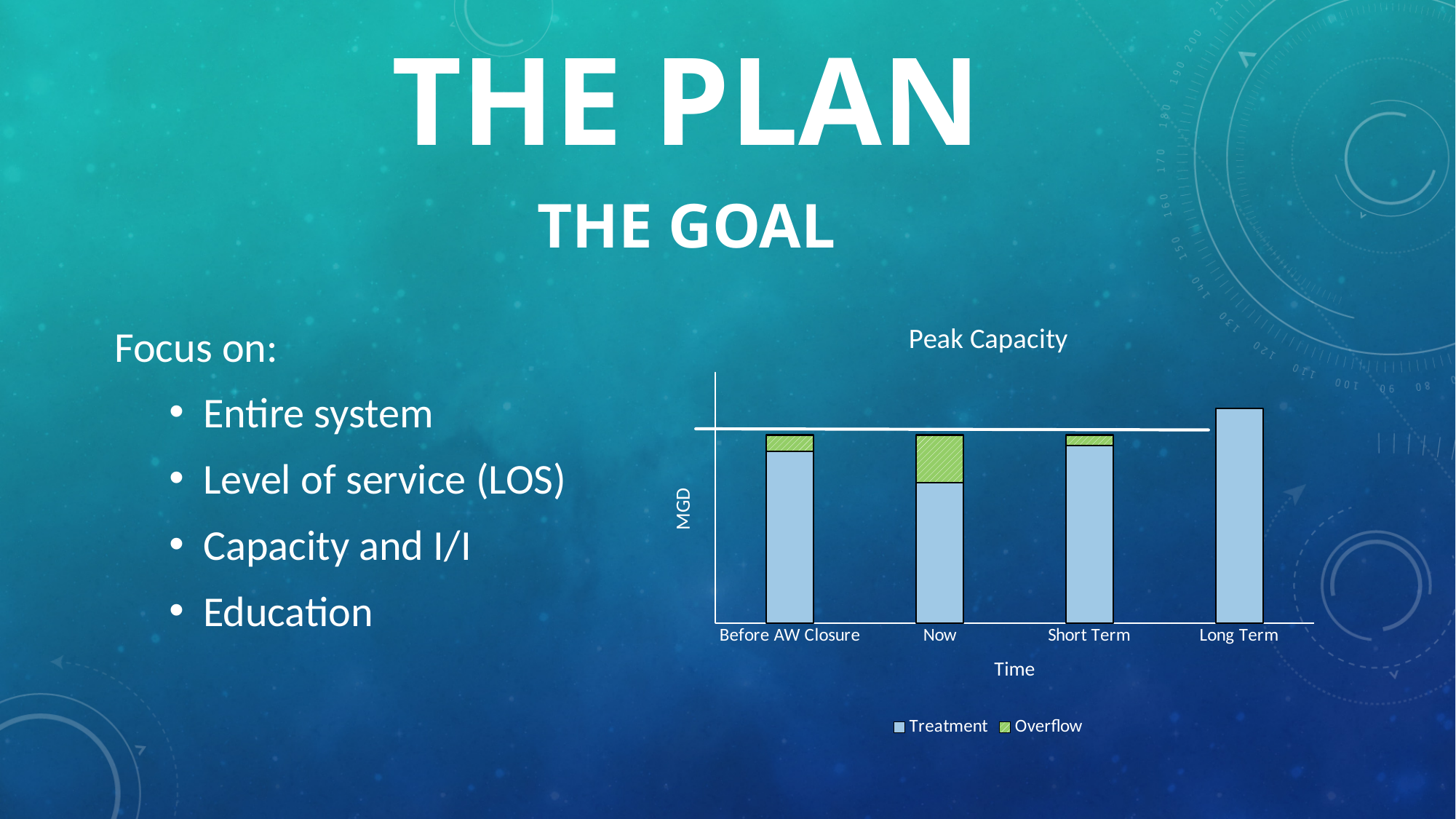
What is the title of the chart? Peak Capacity Does the Treatment value rise or fall from Now to Long Term? Rise How many categories are shown along the x axis of the chart? 4 Which category has the lowest Treatment value? Now What kind of chart is shown on the slide? Stacked bar chart Which category has the highest Treatment value? Long Term Which category shows no Overflow segment? Long Term Is the Overflow value larger for Now or for Before AW Closure? Now What label is shown on the vertical axis of the chart? MGD Which category has the largest Overflow segment? Now How many series does the chart legend list? 2 Is the Treatment value larger for Before AW Closure or for Now? Before AW Closure